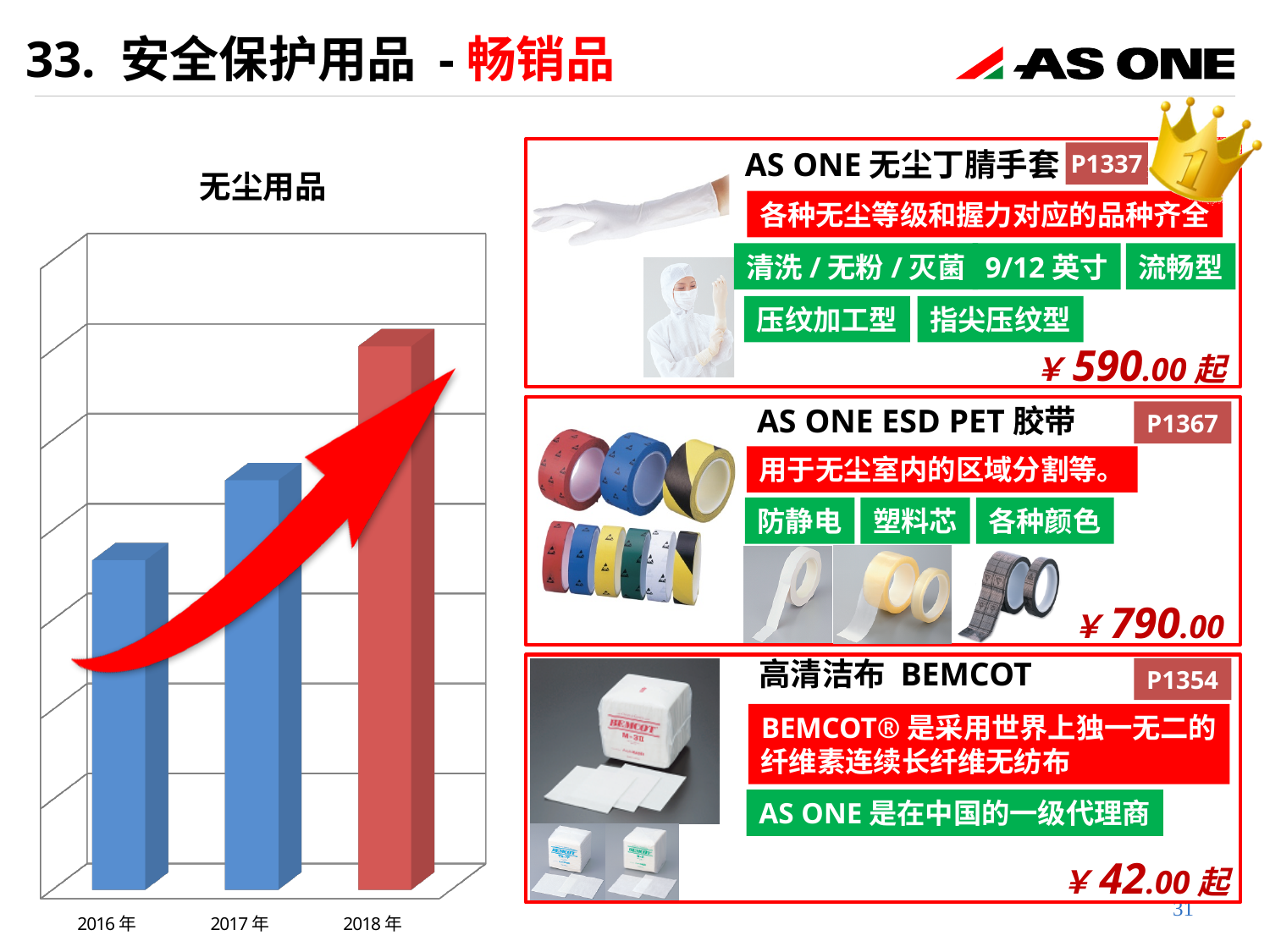
What is the title of the chart on the left of the slide? 无尘用品 What colour is the bar for 2018年 in the chart? red Which year has the highest bar in the chart? 2018年 Is the bar for 2017年 taller or shorter than the bar for 2016年? taller Do the bar values rise or fall from 2016年 to 2018年? rise Is the bar for 2018年 taller or shorter than the bar for 2017年? taller Which year is the first category on the x axis of the chart? 2016年 Which year has the lowest bar in the chart? 2016年 How many categories are shown on the x axis of the chart? 3 What kind of chart is shown on the left of the slide? bar chart